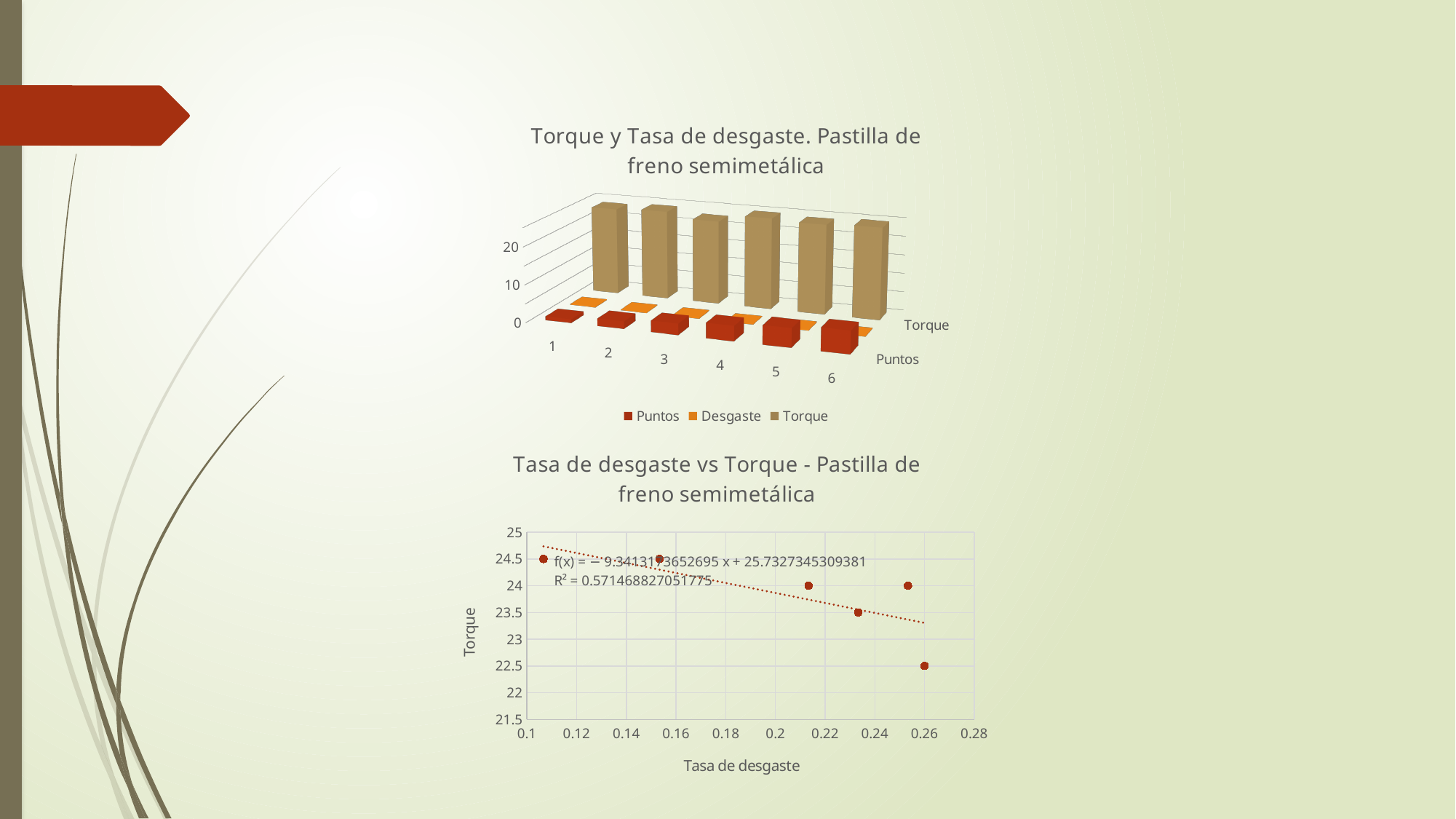
In the top chart 'Torque y Tasa de desgaste', is the Torque value for category 1 greater or less than 20? greater In the top chart 'Torque y Tasa de desgaste', how many series does the legend list? 3 In the bottom chart 'Tasa de desgaste vs Torque', what is the lowest Torque value among the plotted points? 22.5 What kind of chart is the top chart titled 'Torque y Tasa de desgaste. Pastilla de freno semimetálica'? bar chart In the top chart 'Torque y Tasa de desgaste', how many categories are shown on the x axis? 6 In the bottom chart 'Tasa de desgaste vs Torque', does the dotted trendline rise or fall as Tasa de desgaste increases? fall In the top chart 'Torque y Tasa de desgaste', do the Puntos values rise or fall from category 1 to category 6? rise In the bottom chart 'Tasa de desgaste vs Torque', how many data points are plotted? 6 In the top chart 'Torque y Tasa de desgaste', what are the legend entries? Puntos, Desgaste, Torque In the bottom chart 'Tasa de desgaste vs Torque', what is the R² value shown for the trendline? 0.571468827051775 In the top chart 'Torque y Tasa de desgaste', is the Puntos value for category 6 greater or less than 10? less What kind of chart is the bottom chart titled 'Tasa de desgaste vs Torque - Pastilla de freno semimetálica'? scatter chart